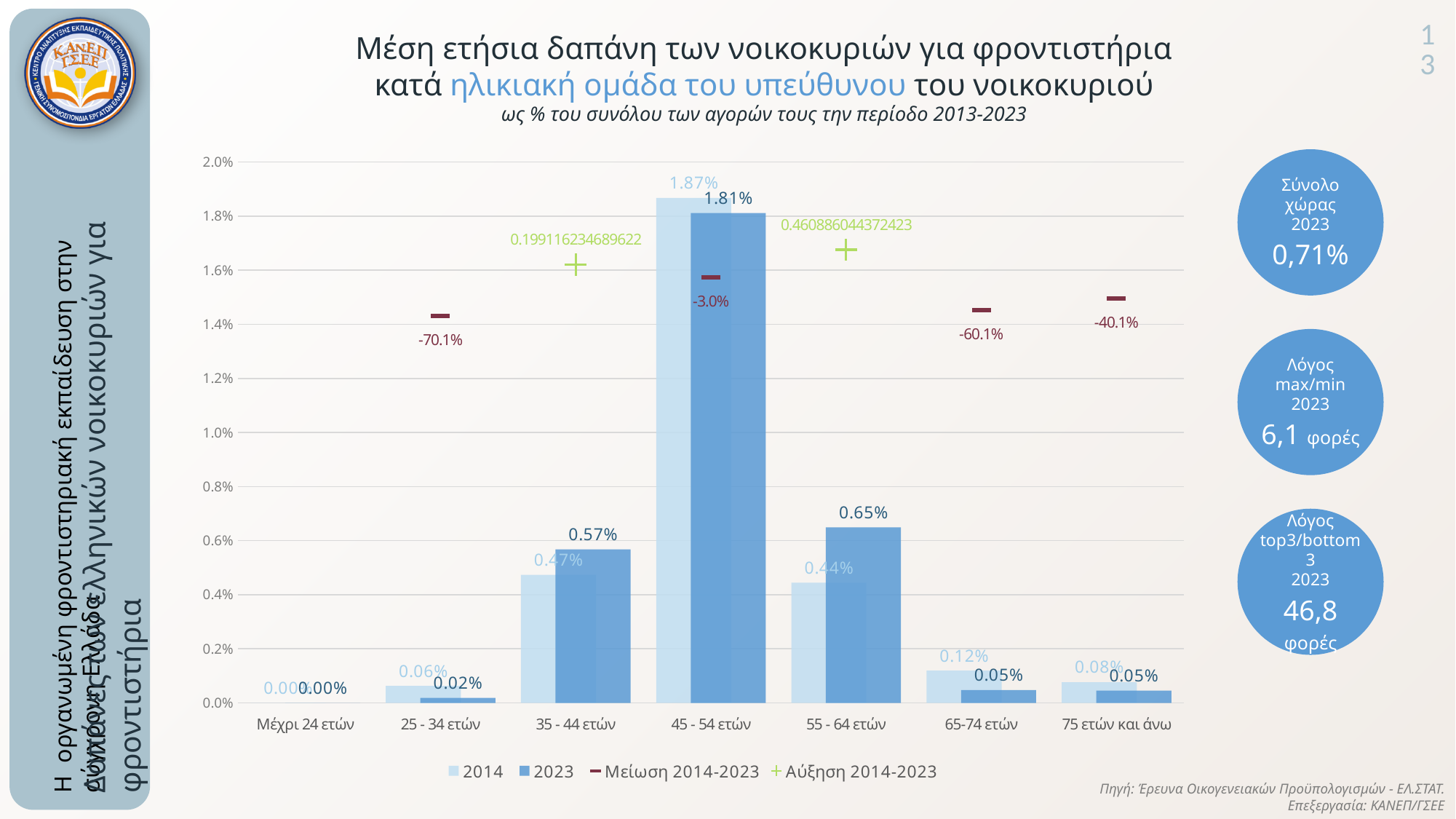
What percentage change (Μείωση 2014-2023) is shown for the 65-74 ετών age group? -60.1% What kind of chart is shown on the slide? Bar chart Which is larger for the 35 - 44 ετών age group, the 2014 value or the 2023 value? 2023 How many entries does the legend list? 4 How many age groups are shown on the x axis? 7 Which age group has the highest 2023 value? 45 - 54 ετών What is the 2023 value for the 25 - 34 ετών age group? 0.02% Which age group has the highest 2014 value? 45 - 54 ετών What is the 2014 value for the 55 - 64 ετών age group? 0.44% What is the 2023 value for the 45 - 54 ετών age group? 1.81% Which is larger for the 65-74 ετών age group, the 2014 value or the 2023 value? 2014 What is the difference between the 2014 and 2023 values for the 55 - 64 ετών age group? 0.21%